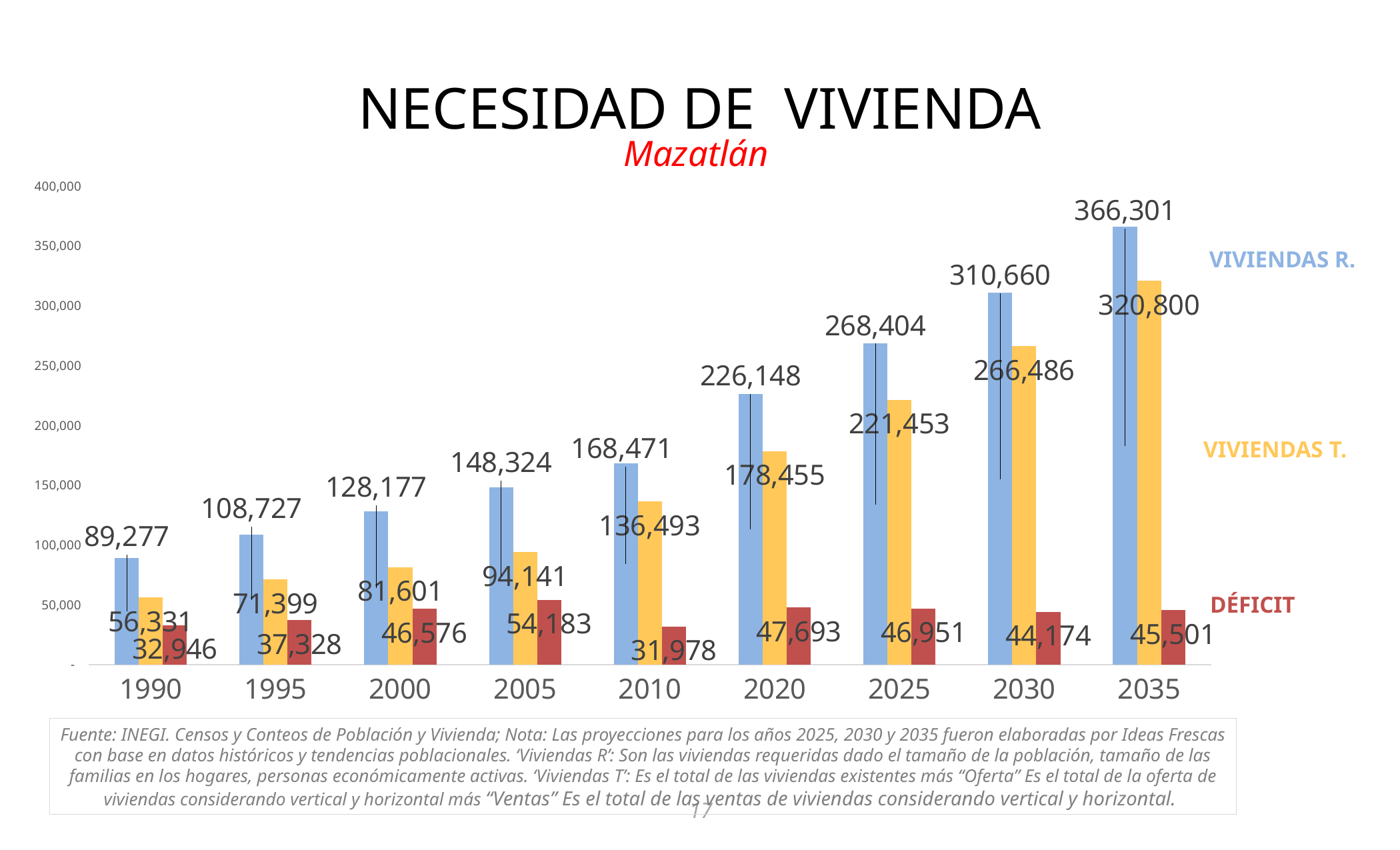
What kind of chart is shown on the slide? Bar chart Do the VIVIENDAS R. values rise or fall from 1990 to 2035? Rise What is the DÉFICIT value for 2005? 54,183 How many years are shown on the x axis? 9 How many series does the chart show? 3 What is the difference between VIVIENDAS R. and VIVIENDAS T. in 2030? 44,174 Which is larger in 2020: VIVIENDAS R. or VIVIENDAS T.? VIVIENDAS R. What is the value of VIVIENDAS T. for 2010? 136,493 In which year is the DÉFICIT highest? 2005 In which year is the DÉFICIT lowest? 2010 What is the value of VIVIENDAS T. for 1990? 56,331 What is the value of VIVIENDAS R. for 2035? 366,301